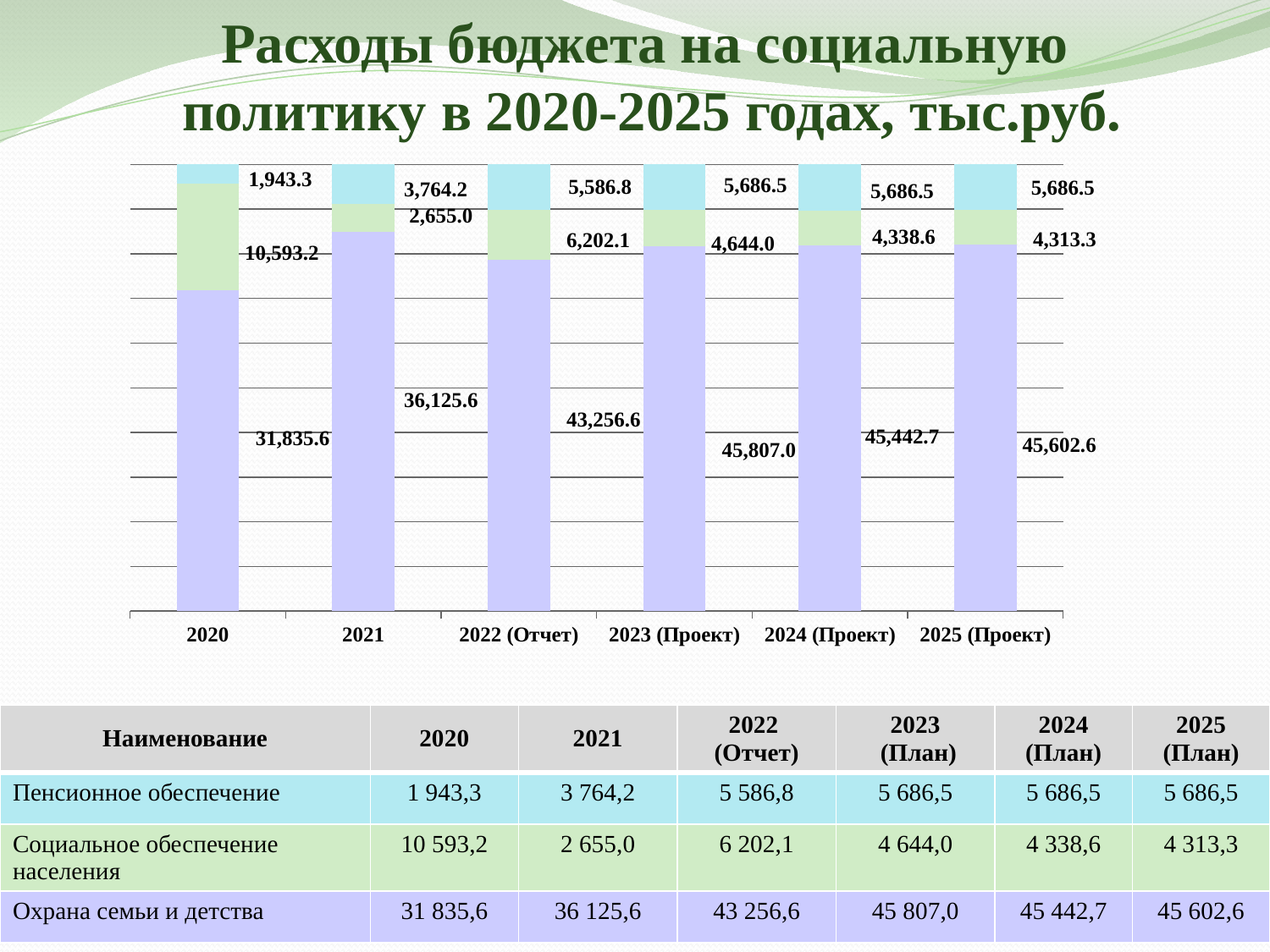
What is the difference between the bottom (lilac) segment values for 2025 (Проект) and 2020? 13,767.0 What is the value of the bottom (lilac) segment for 2022 (Отчет) in the chart? 43,256.6 For 2022 (Отчет), which is larger: the green segment (6,202.1) or the light blue segment (5,586.8)? the green segment (6,202.1) What is the value of the top (light blue) segment for 2020 in the chart? 1,943.3 What is the total of the stacked bar for 2021? 42,544.8 In which year is the bottom (lilac) segment, Охрана семьи и детства, the largest? 2023 (Проект) Does the bottom (lilac) segment rise or fall from 2020 to 2022 (Отчет)? rise In which year is the middle (green) segment, Социальное обеспечение населения, the smallest? 2021 In which year is the middle (green) segment, Социальное обеспечение населения, the largest? 2020 What kind of chart is shown on the slide? stacked bar chart What is the value of the middle (green) segment for 2024 (Проект) in the chart? 4,338.6 How many years (categories) are shown on the x axis of the chart? 6